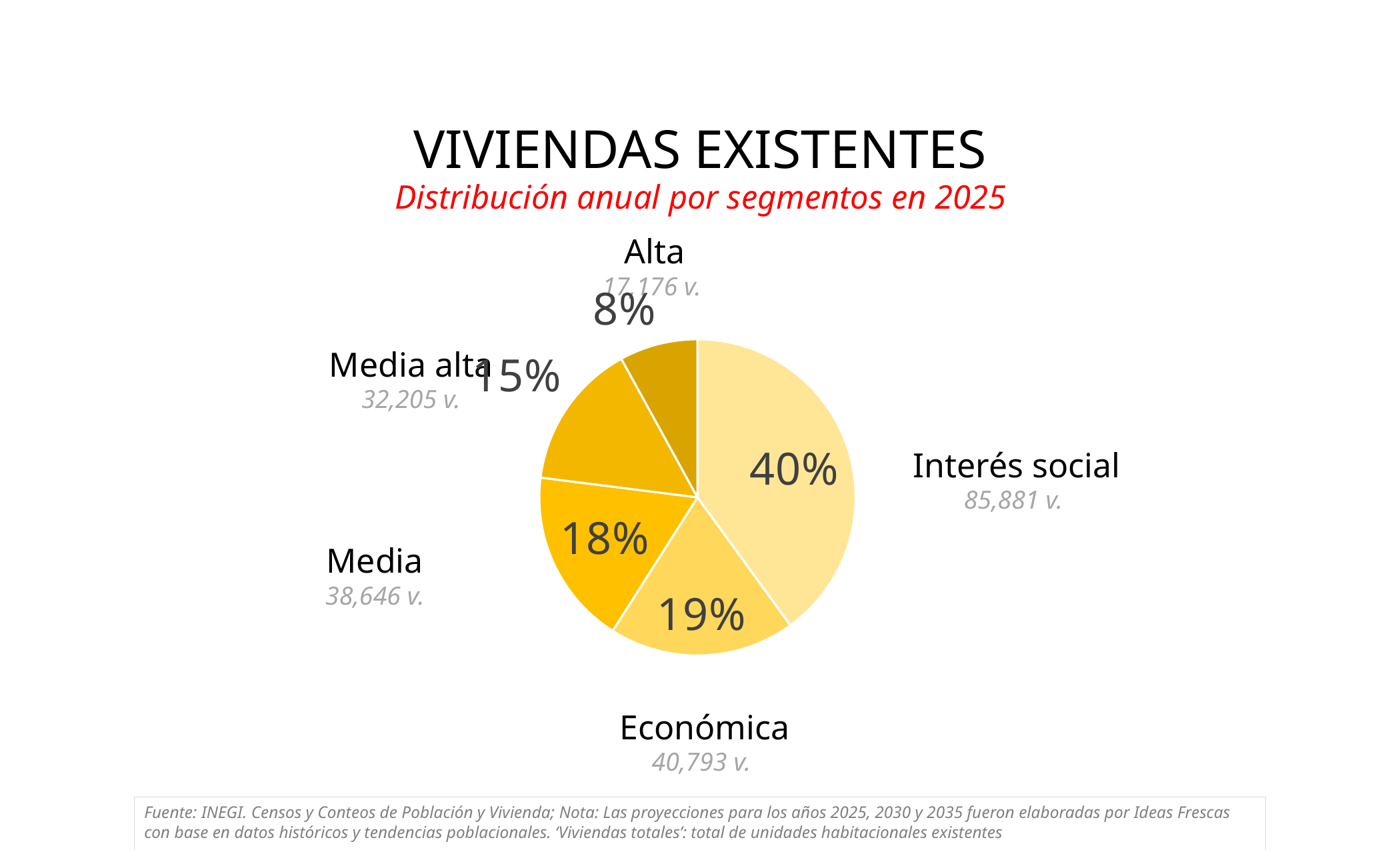
What is the red subtitle of the chart? Distribución anual por segmentos en 2025 How many segments does the pie chart have? 5 What share of the pie does the Alta segment represent? 8% What kind of chart is shown on the slide? pie chart Which segment has more viviendas, Media alta or Alta? Media alta What is the difference in viviendas between Interés social and Económica? 45,088 How many viviendas are shown for the Media segment? 38,646 v. How many viviendas are shown for the Media alta segment? 32,205 v. Which segment has the smallest share of the pie? Alta Which segment has the largest share of the pie? Interés social How many viviendas are shown for the Económica segment? 40,793 v. What share of the pie does the Interés social segment represent? 40%